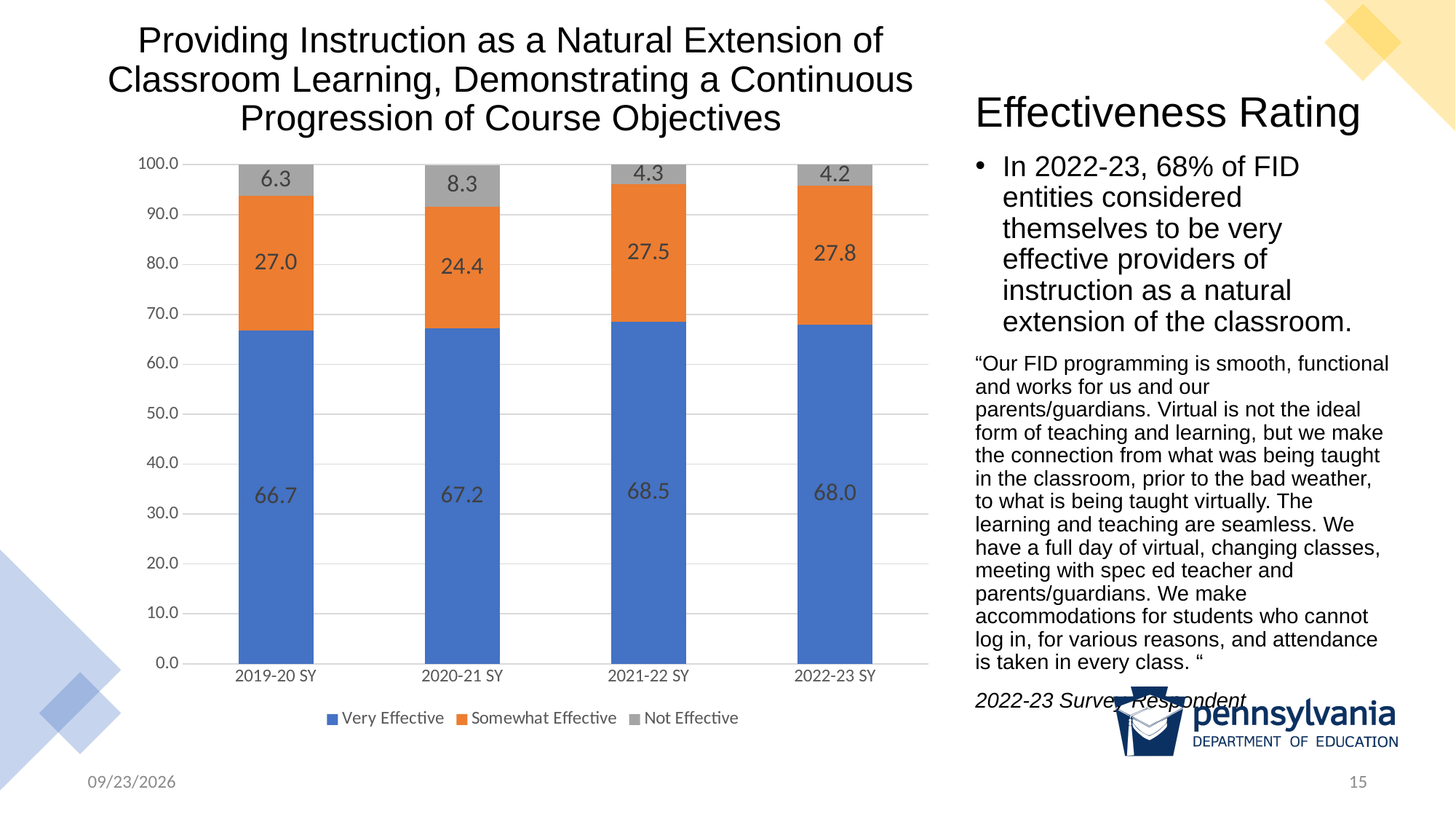
Which school year has the highest Very Effective value? 2021-22 SY What is the total of the stacked bar for 2022-23 SY? 100.0 What kind of chart is shown on the slide? Stacked bar chart Which is larger, the Somewhat Effective value for 2019-20 SY or for 2020-21 SY? 2019-20 SY What is the Very Effective value for 2022-23 SY? 68.0 What is the difference between the Not Effective values for 2020-21 SY and 2021-22 SY? 4.0 How many school years are shown on the x axis? 4 Which school year has the lowest Not Effective value? 2022-23 SY How many series does the legend list? 3 What is the Somewhat Effective value for 2020-21 SY? 24.4 What is the Not Effective value for 2019-20 SY? 6.3 Which colour represents the Not Effective series in the legend? Gray